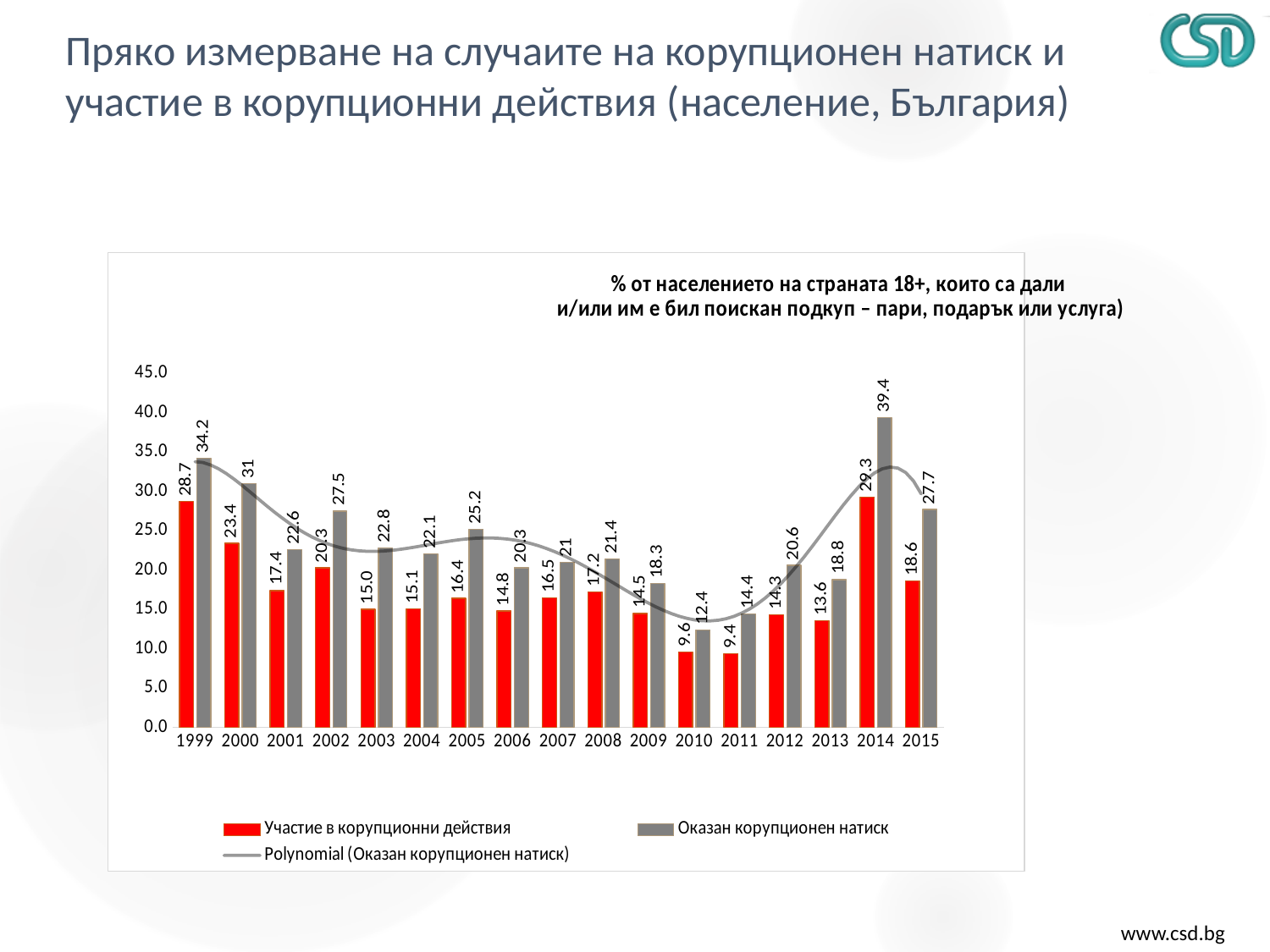
What is the value for Оказан корупционен натиск in 2014? 39.4 What is the value for Участие в корупционни действия in 1999? 28.7 What kind of chart is shown on the slide? Bar chart In which year is Оказан корупционен натиск highest? 2014 What is the value for Оказан корупционен натиск in 2010? 12.4 Is the value for Оказан корупционен натиск in 2005 greater or less than 20.0? greater What is the difference between Оказан корупционен натиск and Участие в корупционни действия in 2015? 9.1 How many entries does the legend list? 3 Which is larger: Участие в корупционни действия in 2000 or in 2014? 2014 In which year is Участие в корупционни действия lowest? 2011 Which colour represents Участие в корупционни действия? Red How many years are shown on the x axis? 17